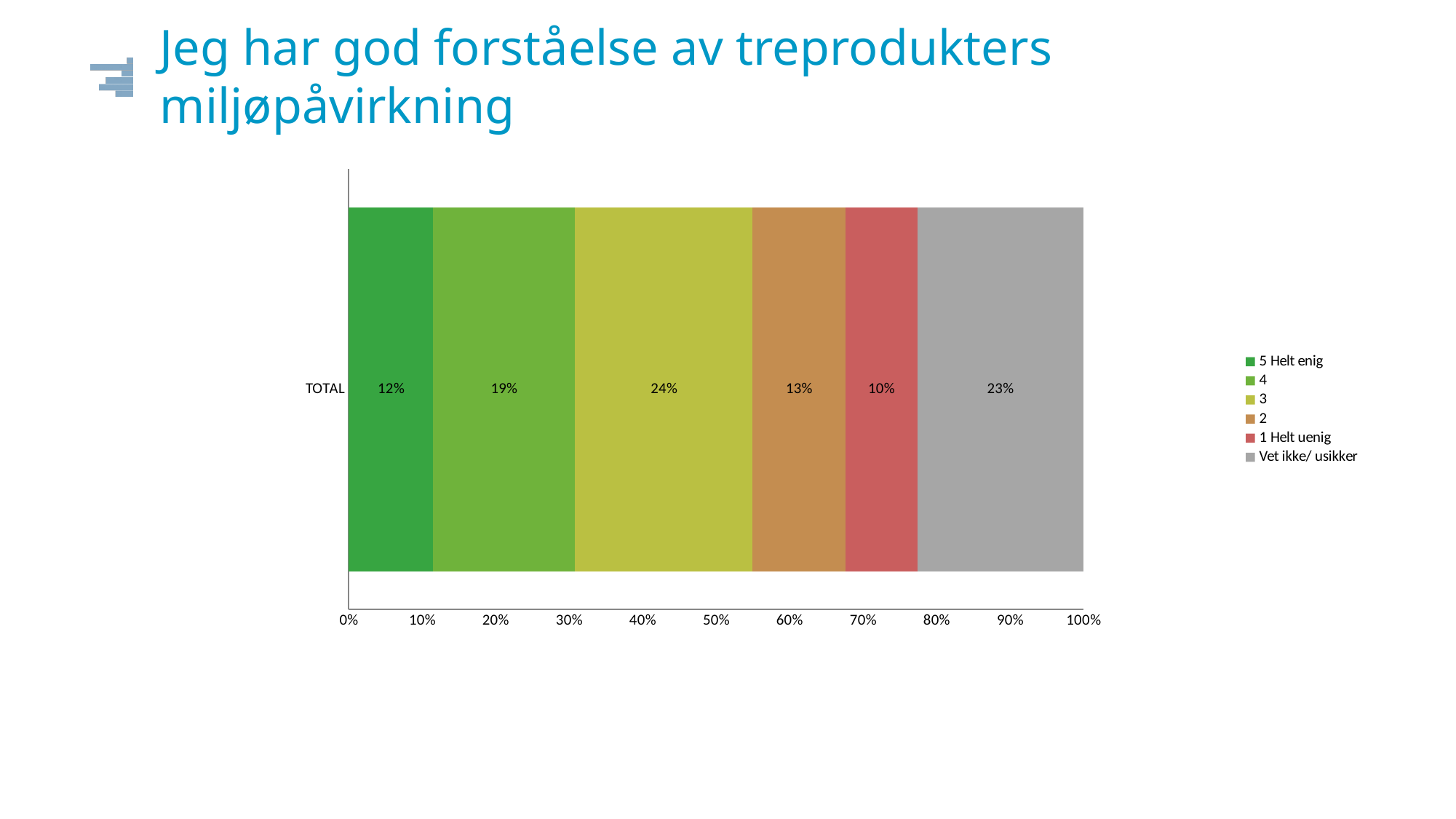
How many series does the legend list? 6 What percentage of respondents answered "3"? 24% What percentage of respondents answered "Vet ikke/ usikker"? 23% What is the label of the single category on the vertical axis? TOTAL What is the combined share of "5 Helt enig" and "4"? 31% What kind of chart is shown on the slide? Stacked bar chart Which response category has the smallest share of the TOTAL bar? 1 Helt uenig What percentage of respondents answered "1 Helt uenig"? 10% Which response category has the largest share of the TOTAL bar? 3 Which is larger, the share for "Vet ikke/ usikker" or the share for "4"? Vet ikke/ usikker What percentage of respondents answered "5 Helt enig"? 12% What is the difference between the share for "4" and the share for "2"? 6%